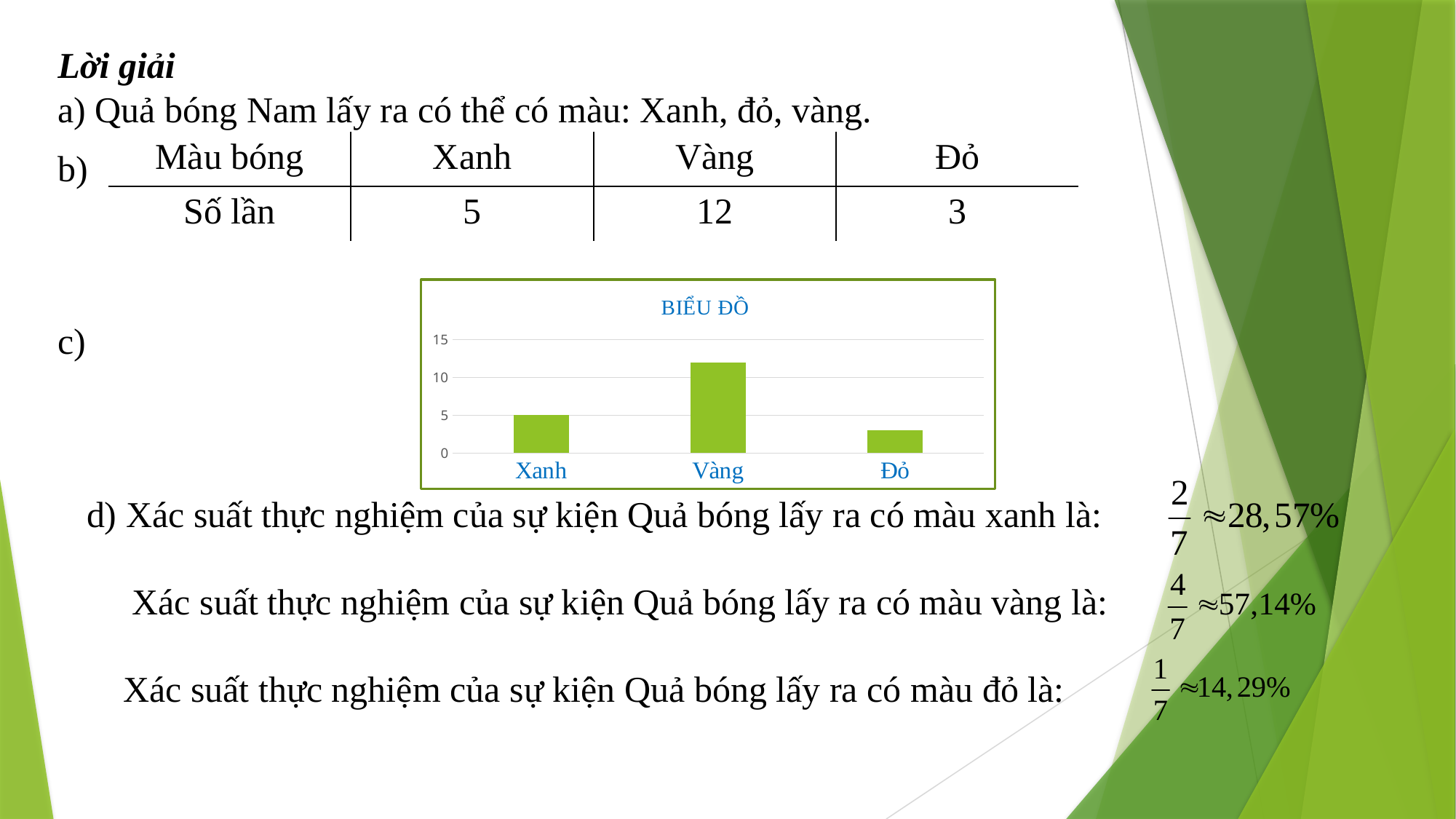
What is the value of the bar for Đỏ? 3 Which category has the lowest bar in the chart? Đỏ Is the value for Đỏ greater or less than 5? less What is the value of the bar for Vàng? 12 Which category has the highest bar in the chart? Vàng What kind of chart is shown on the slide? bar chart How many categories are shown on the x axis of the chart? 3 What is the title of the chart? BIỂU ĐỒ What is the difference between the values for Vàng and Xanh? 7 What is the value of the bar for Xanh? 5 Is the value for Vàng greater or less than 10? greater Which is larger, the bar for Xanh or the bar for Đỏ? Xanh